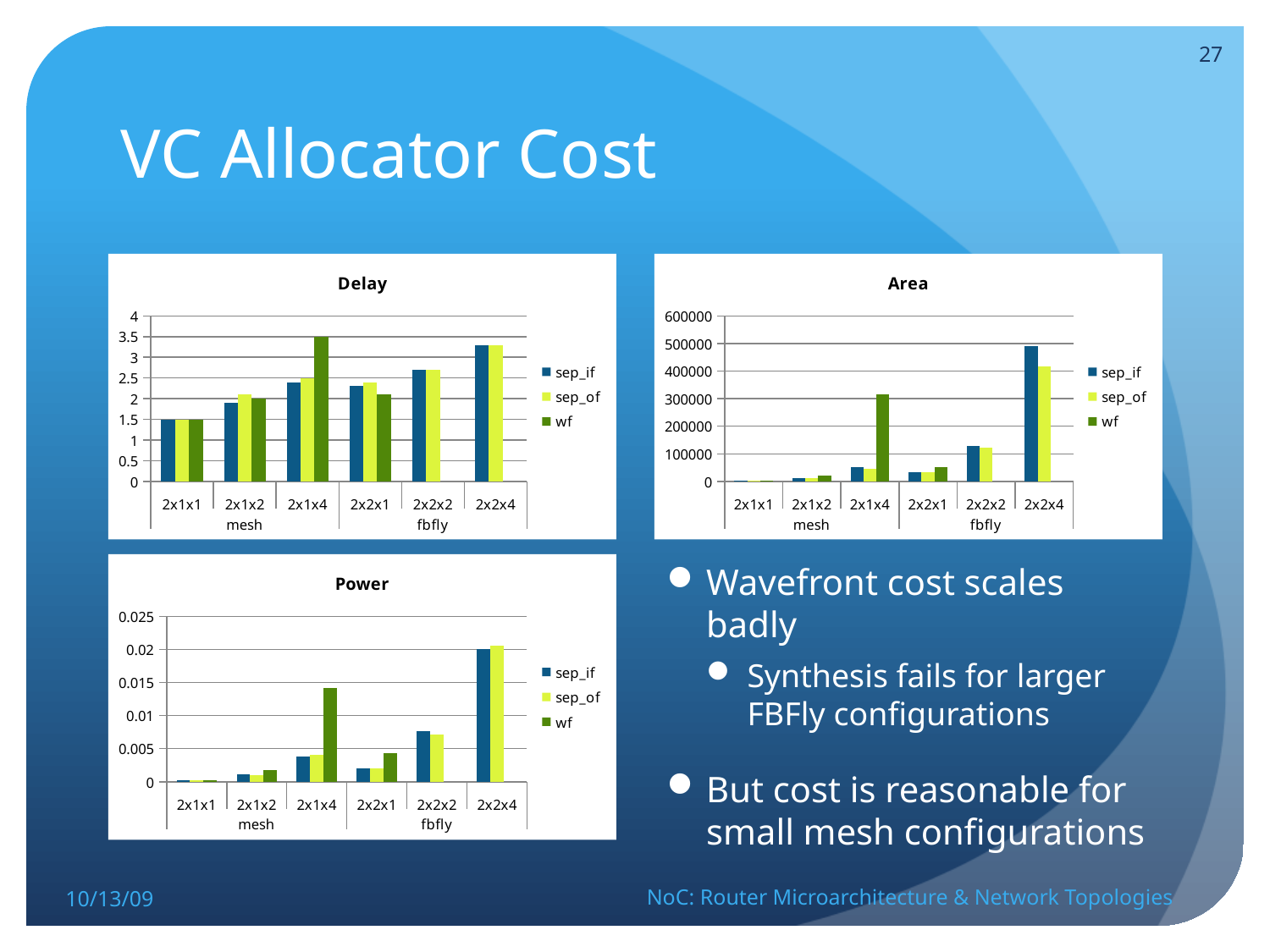
What kind of chart is the Delay chart? bar chart In the Area chart, is the value for sep_if at 2x2x4 greater or less than 400000? greater In the Power chart, which configuration has the lowest values across all series? 2x1x1 In the Delay chart, is the value for sep_if at 2x2x4 greater or less than 3? greater In the Area chart, which configuration has the highest sep_if value? 2x2x4 How many configuration categories are shown on the x axis of the Power chart? 6 In the Delay chart, what is the delay value for sep_if at 2x1x1? 1.5 In the Delay chart, which series has the tallest bar overall? wf In the Area chart, which is larger at 2x1x4: sep_if or wf? wf In the Power chart, is the value for wf at 2x1x4 greater or less than 0.01? greater How many series does the legend of the Area chart list? 3